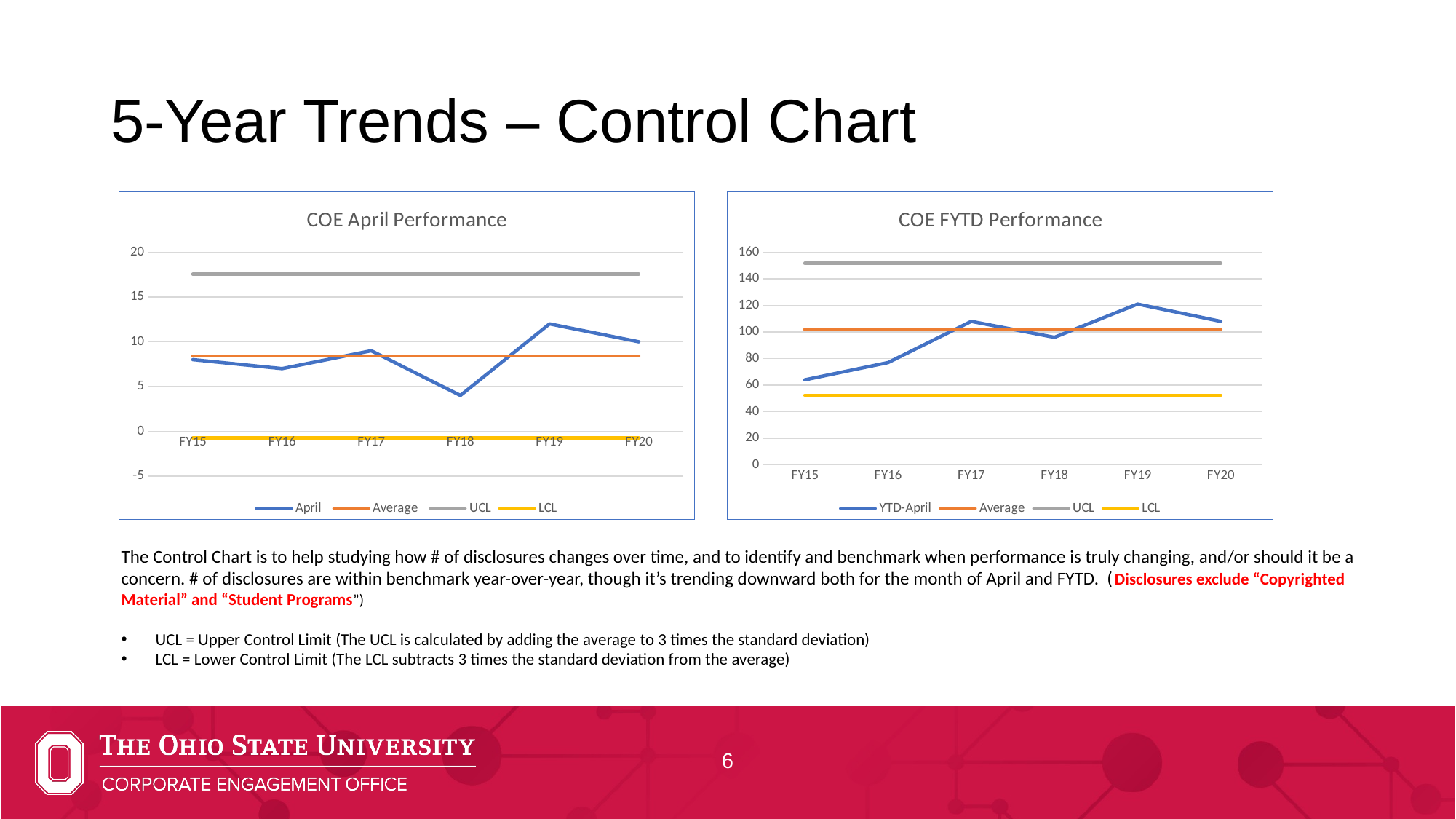
In the COE FYTD Performance chart, which fiscal year has the highest YTD-April value? FY19 How many fiscal years are plotted on the x axis of the COE FYTD Performance chart? 6 What are the legend entries of the COE FYTD Performance chart? YTD-April, Average, UCL, LCL In the COE FYTD Performance chart, which fiscal year has the lowest YTD-April value? FY15 In the COE April Performance chart, which fiscal year has the highest April value? FY19 In the COE April Performance chart, is the April value for FY18 greater or less than 5? less In the COE FYTD Performance chart, is the YTD-April value for FY15 greater or less than 80? less In the COE FYTD Performance chart, is the UCL line greater or less than 140? greater In the COE April Performance chart, which fiscal year has the lowest April value? FY18 How many series does the legend of the COE April Performance chart list? 4 In the COE FYTD Performance chart, which is larger, the YTD-April value for FY17 or for FY18? FY17 What kind of chart is the COE April Performance chart? line chart